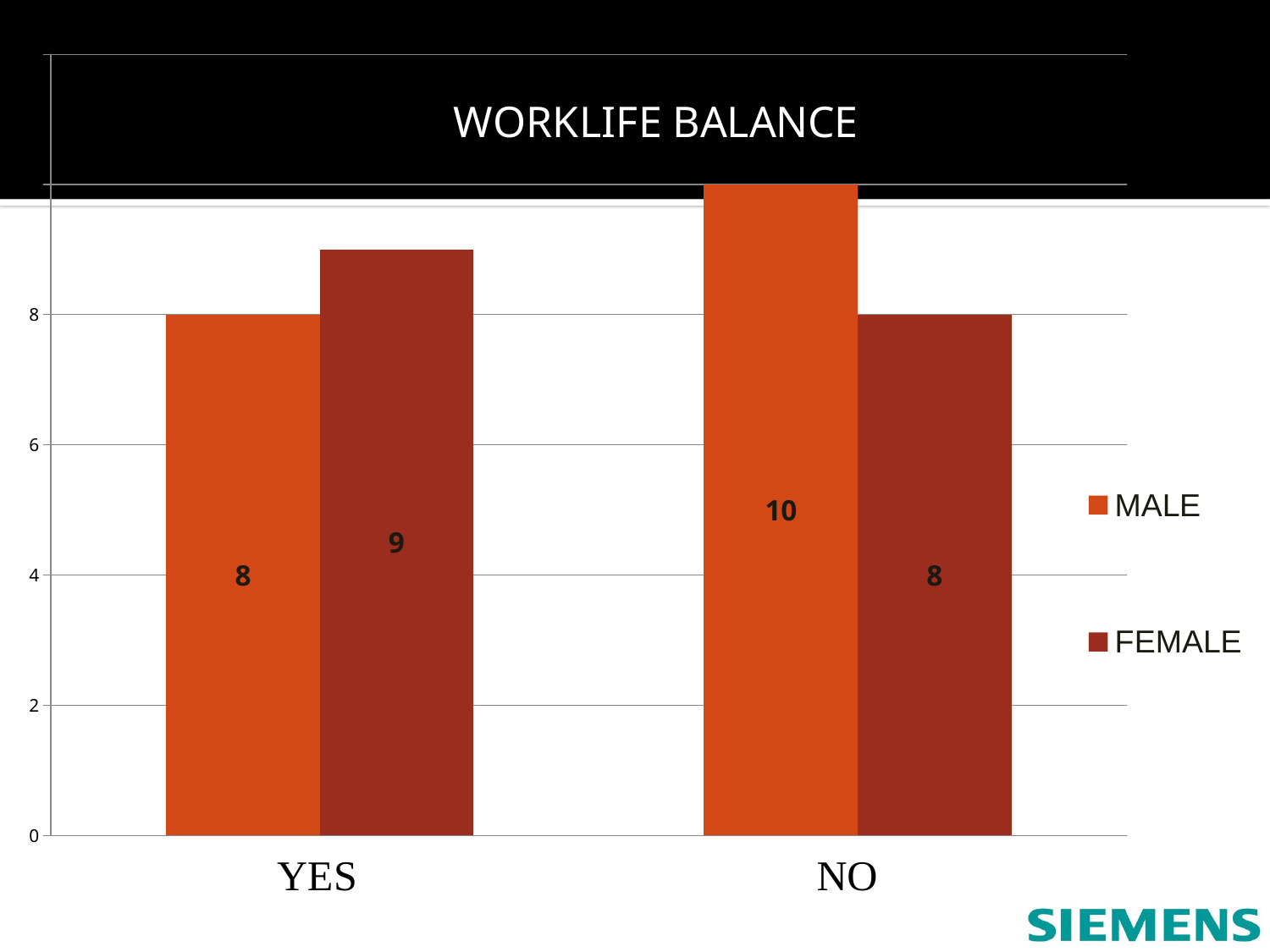
For YES, which is larger, the MALE value or the FEMALE value? FEMALE Which category has the highest MALE value? NO What is the MALE value for YES? 8 What is the title of the chart? WORKLIFE BALANCE What is the FEMALE value for NO? 8 What is the MALE value for NO? 10 How many series does the legend list? 2 What is the difference between the MALE and FEMALE values for NO? 2 Which category has the lowest FEMALE value? NO What is the FEMALE value for YES? 9 What kind of chart is shown on the slide? Bar chart How many categories are shown on the x axis? 2